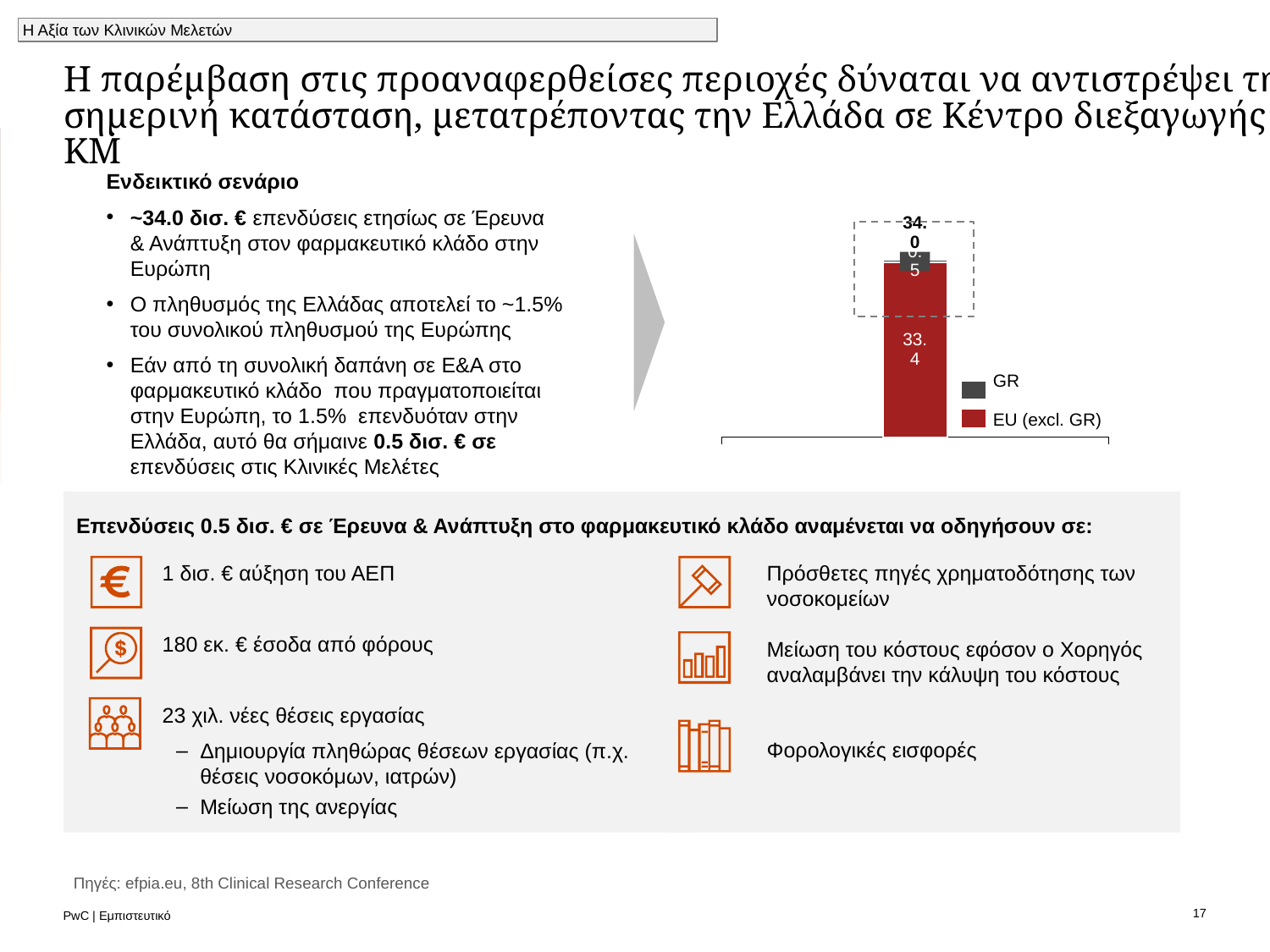
How many bars are plotted in the chart? 1 What is the difference between the EU (excl. GR) value and the GR value? 32.9 What is the total of the stacked bar? 34.0 What is the value of the GR segment of the bar? 0.5 Which series has the largest value in the bar? EU (excl. GR) What kind of chart is shown on the slide? Stacked bar chart What is the value of the EU (excl. GR) segment of the bar? 33.4 What colour represents EU (excl. GR) in the chart legend? Red Which series has the smallest value in the bar? GR How many series does the chart legend list? 2 Which segment is larger, GR or EU (excl. GR)? EU (excl. GR) What colour represents GR in the chart legend? Dark grey